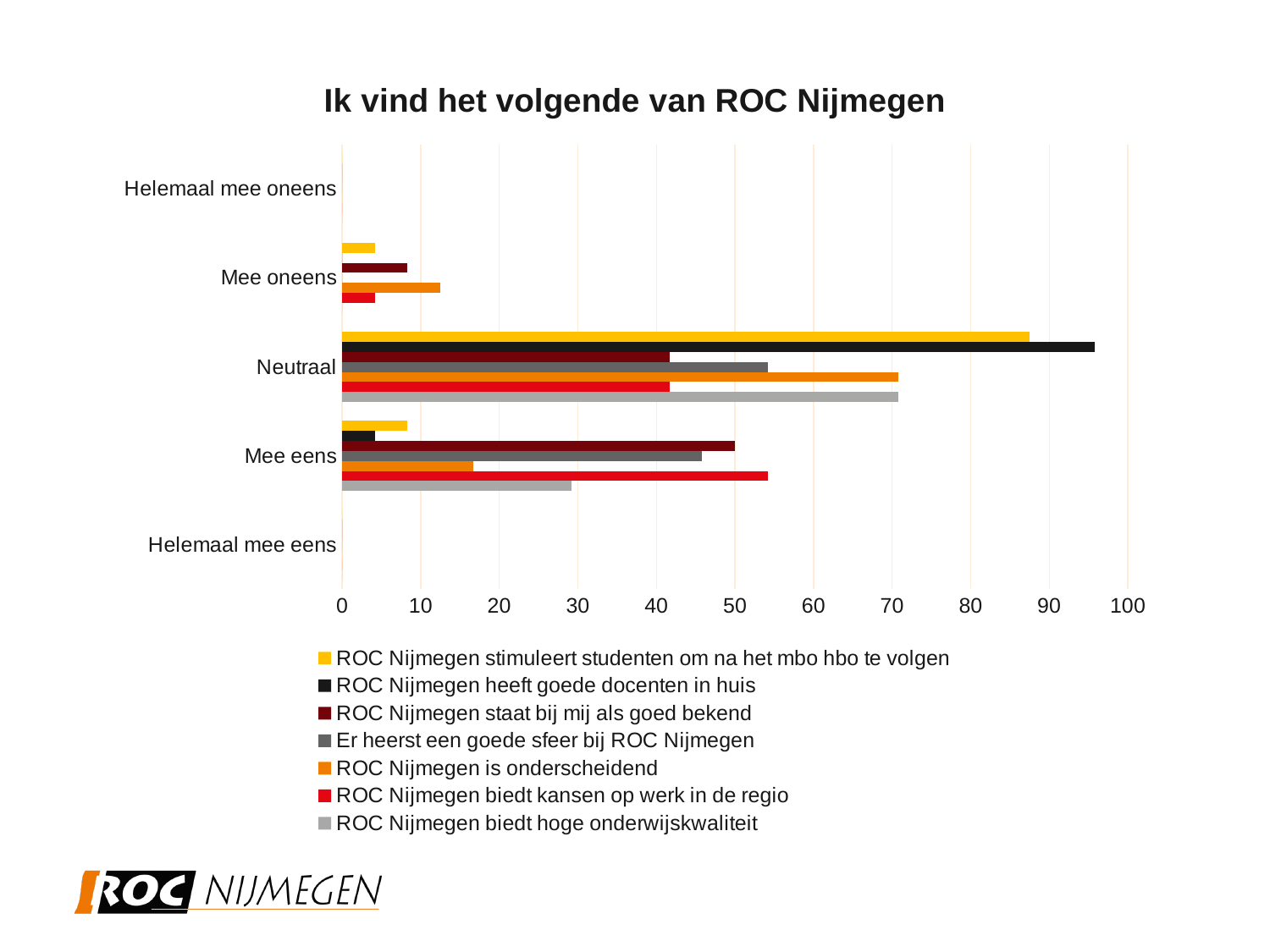
Is the value for 'ROC Nijmegen stimuleert studenten om na het mbo hbo te volgen' in the Neutraal category greater or less than 80? greater Which series has the shortest bar in the Mee eens category? ROC Nijmegen heeft goede docenten in huis What kind of chart is shown on the slide? bar chart Is the value for 'ROC Nijmegen biedt kansen op werk in de regio' in the Mee eens category greater or less than 50? greater Is the value for 'ROC Nijmegen is onderscheidend' in the Mee eens category greater or less than 20? less What is the title of the chart? Ik vind het volgende van ROC Nijmegen How many response categories are shown on the vertical axis? 5 In the Mee eens category, which is larger: the value for 'ROC Nijmegen biedt hoge onderwijskwaliteit' or the value for 'ROC Nijmegen is onderscheidend'? ROC Nijmegen biedt hoge onderwijskwaliteit Which series has the longest bar in the Neutraal category? ROC Nijmegen heeft goede docenten in huis Which series has the longest bar in the Mee oneens category? ROC Nijmegen is onderscheidend How many series does the legend list? 7